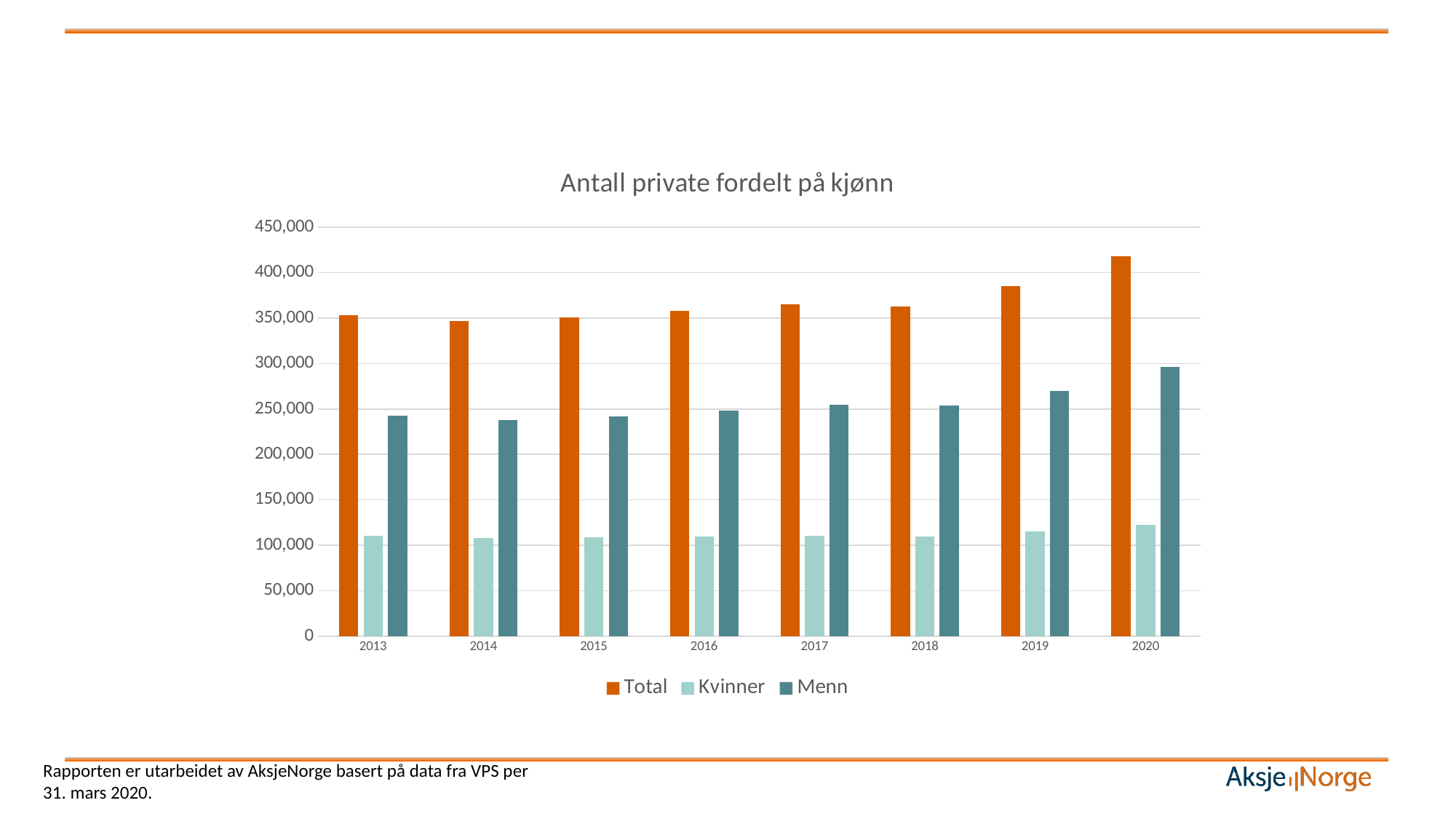
In which year is the Menn value highest? 2020 Is the Total value for 2019 greater or less than 400,000? less Is the Menn value for 2019 greater or less than 250,000? greater How many series does the legend list? 3 In which year is the Total value highest? 2020 Is the Total value for 2020 greater or less than 400,000? greater How many years are shown on the x axis? 8 In which year is the Kvinner value highest? 2020 Which series is shown in orange? Total Which is larger, the Total value for 2019 or the Total value for 2018? 2019 What kind of chart is shown on the slide? bar chart What is the title of the chart? Antall private fordelt på kjønn